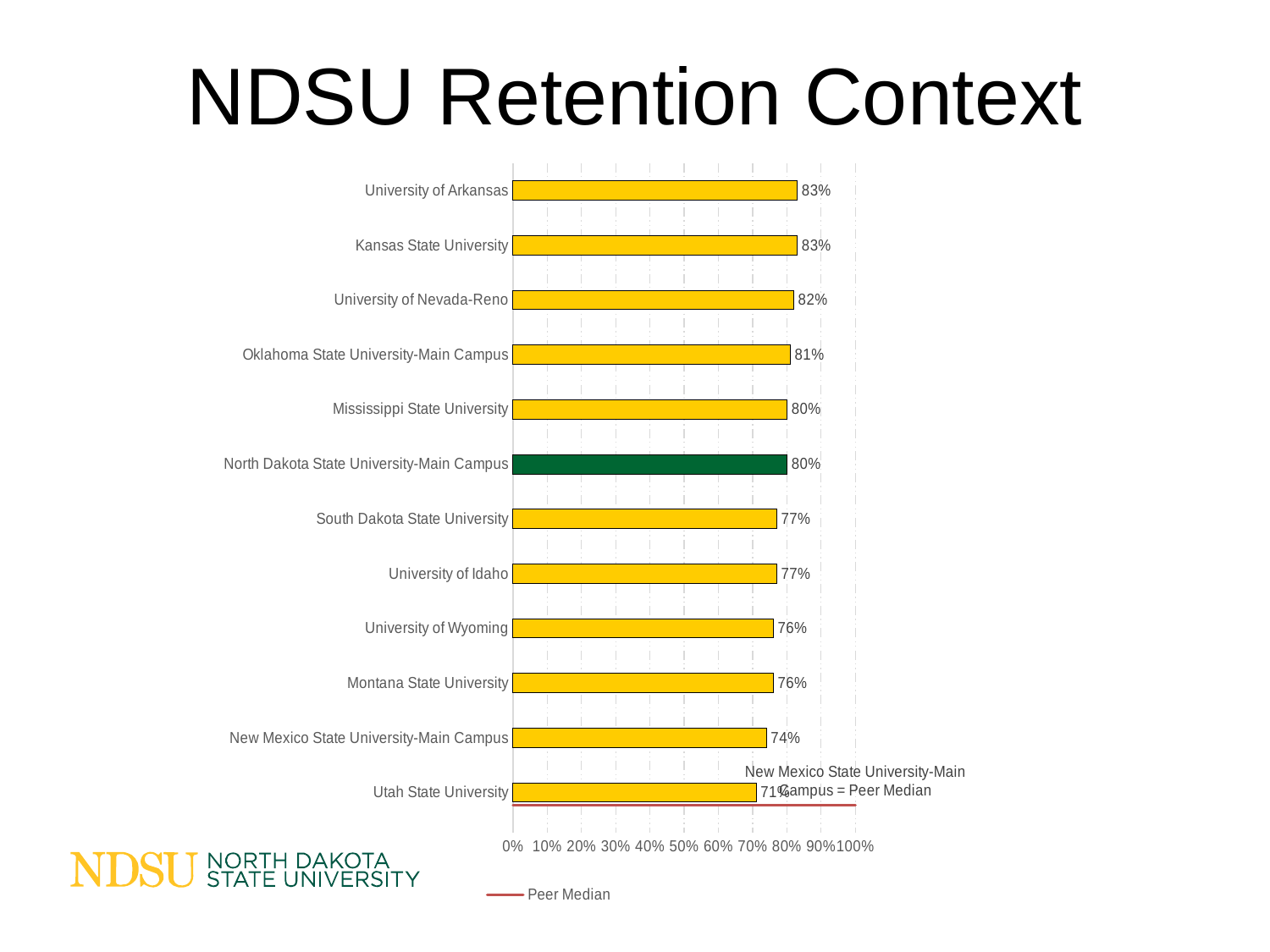
What is the retention value for North Dakota State University-Main Campus? 80% What is the value shown for New Mexico State University-Main Campus? 74% What is the difference between the values for University of Arkansas and Utah State University? 12% What is the difference between the values for North Dakota State University-Main Campus and South Dakota State University? 3% What is the value shown for University of Nevada-Reno? 82% How many universities are shown on the chart? 12 Which has a larger value, Oklahoma State University-Main Campus or University of Wyoming? Oklahoma State University-Main Campus Which university has the lowest value on the chart? Utah State University Is the value for Montana State University greater or less than 80%? less What is the value shown for Utah State University? 71% Which university's bar is coloured green instead of yellow? North Dakota State University-Main Campus What kind of chart is shown on the slide? bar chart